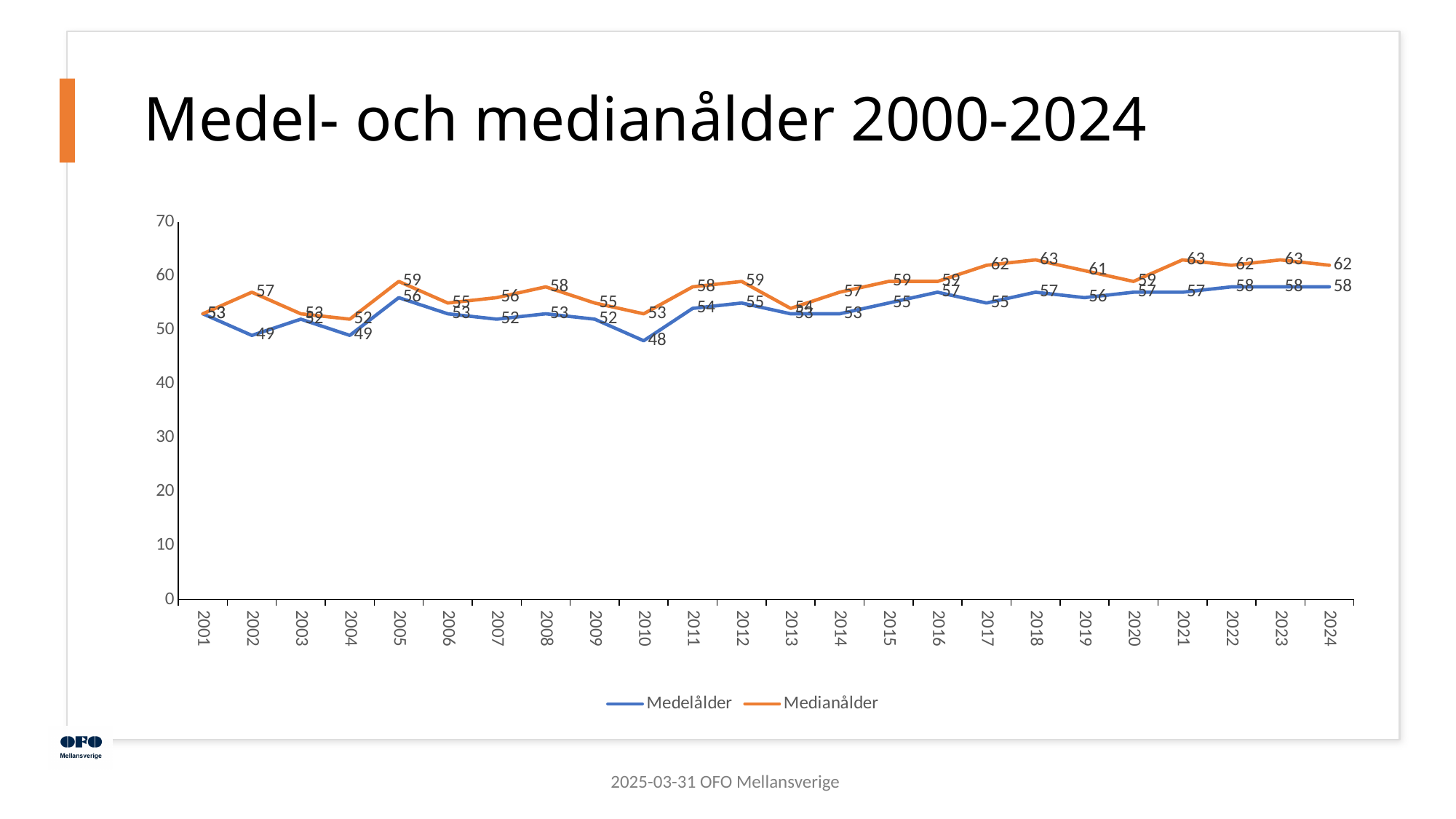
In which year is Medelålder at its lowest? 2010 What is the difference between Medianålder and Medelålder in 2024? 4 Does Medianålder rise or fall from 2013 to 2018? rise What is the Medelålder value for 2010? 48 What is the Medianålder value for 2018? 63 How many years are plotted on the x axis? 24 How many series does the legend list? 2 What is the Medianålder value for 2002? 57 What is the Medelålder value for 2005? 56 What are the two series named in the legend? Medelålder and Medianålder In 2002, which is larger, Medelålder or Medianålder? Medianålder What kind of chart is shown on the slide? line chart